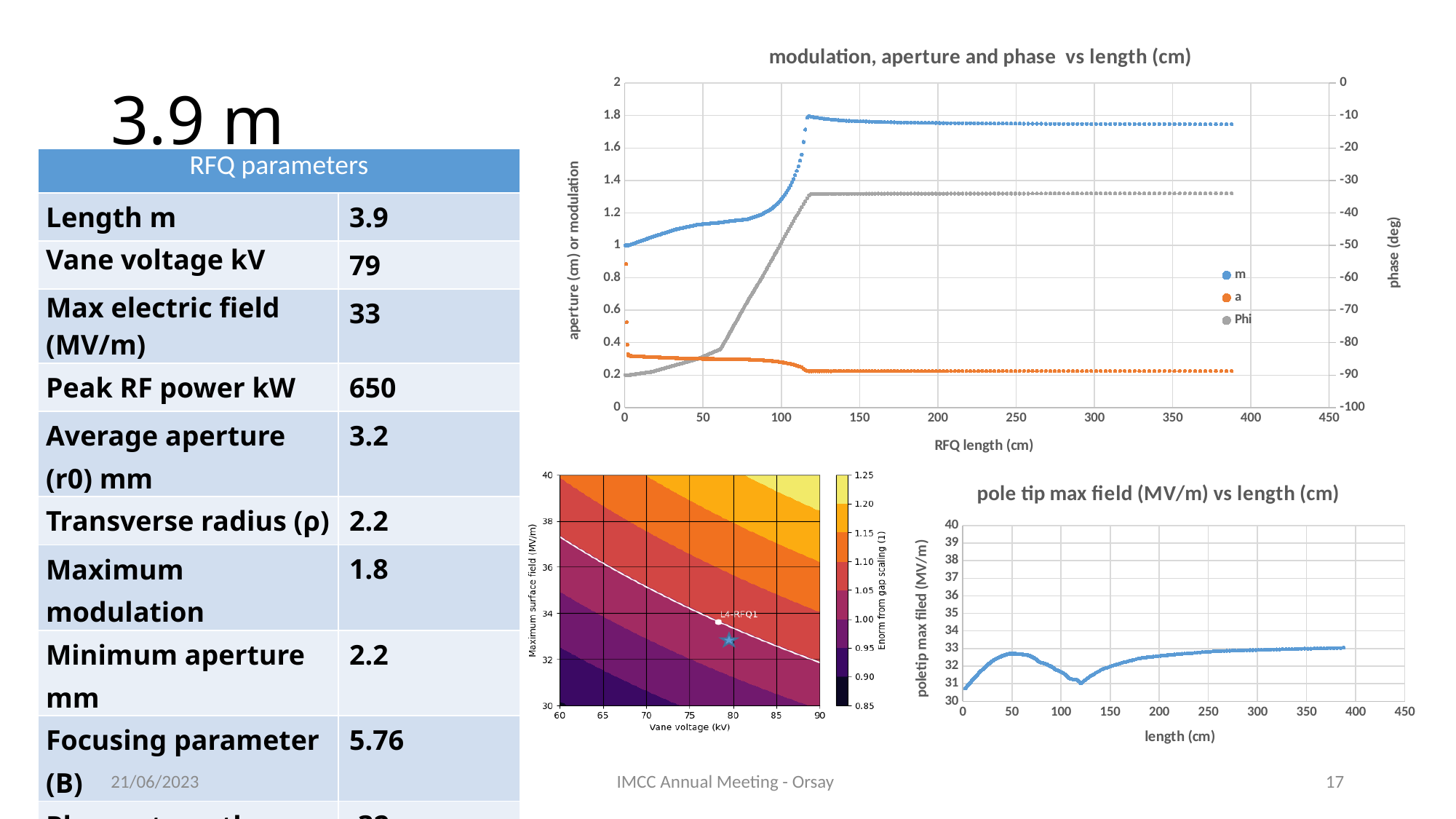
In the chart titled 'modulation, aperture and phase vs length (cm)', what are the legend entries? m, a, Phi In the chart titled 'modulation, aperture and phase vs length (cm)', what is the label of the right-hand vertical axis? phase (deg) In the chart titled 'modulation, aperture and phase vs length (cm)', is the value of the m series at an RFQ length of 300 cm greater or less than 1.6? greater In the chart titled 'modulation, aperture and phase vs length (cm)', does the a series overall rise or fall as RFQ length increases? fall In the chart titled 'modulation, aperture and phase vs length (cm)', is the value of the a series at an RFQ length of 300 cm greater or less than 0.4? less In the chart titled 'modulation, aperture and phase vs length (cm)', does the Phi series rise or fall as RFQ length increases from 0 to 150 cm? rise In the chart titled 'pole tip max field (MV/m) vs length (cm)', is the value at a length of 300 cm greater or less than 32? greater In the chart titled 'pole tip max field (MV/m) vs length (cm)', does the value overall rise or fall as length increases from 150 cm to 350 cm? rise What kind of chart is the one titled 'pole tip max field (MV/m) vs length (cm)'? scatter (line) chart In the chart titled 'modulation, aperture and phase vs length (cm)', how many series does the legend list? 3